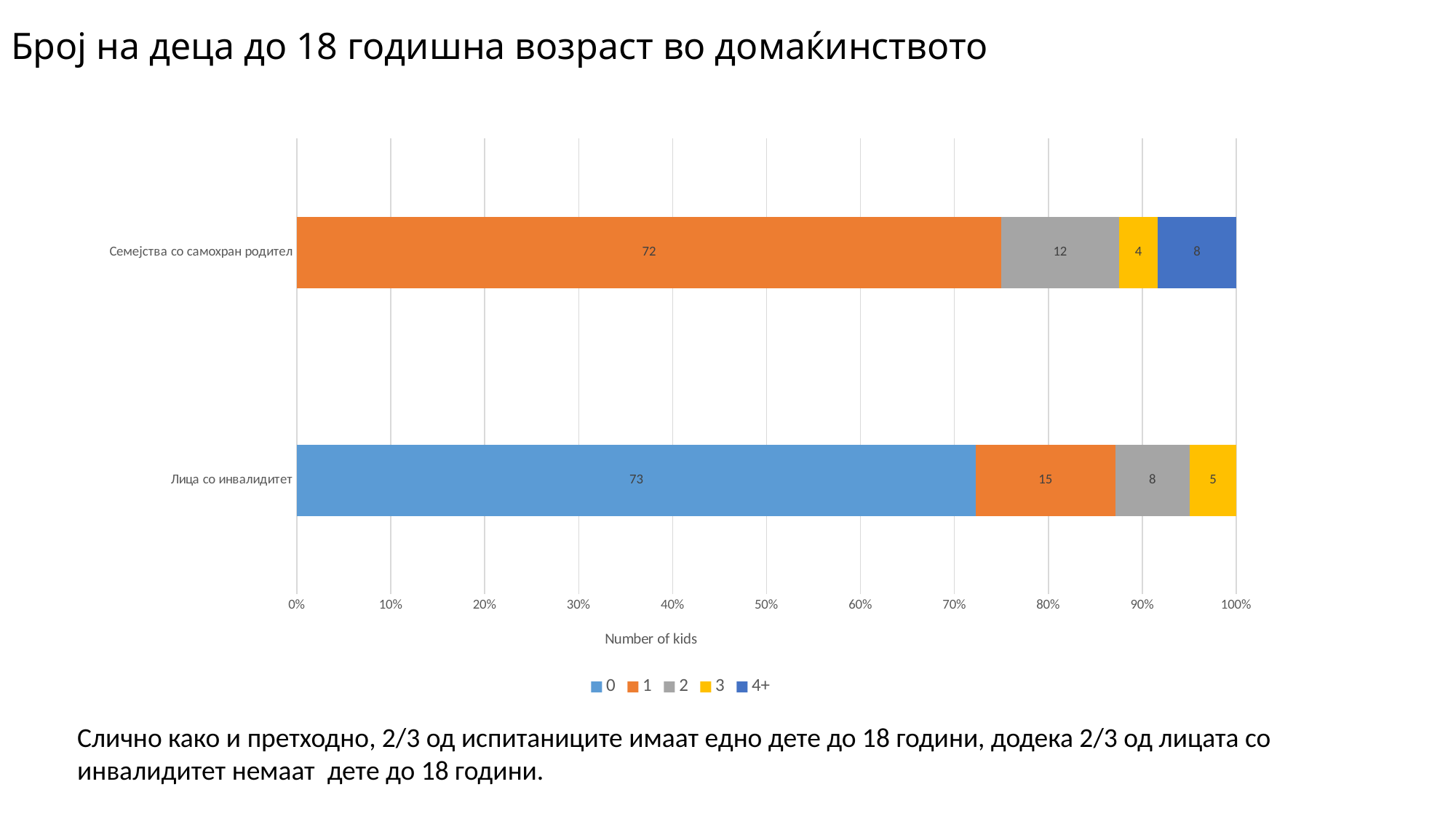
Which is larger: the value for series "2" in "Семејства со самохран родител" or the value for series "2" in "Лица со инвалидитет"? Семејства со самохран родител What kind of chart is shown on the slide? Stacked bar chart What is the value for series "4+" in the "Семејства со самохран родител" bar? 8 What is the value for series "1" in the "Семејства со самохран родител" bar? 72 What is the value for series "3" in the "Лица со инвалидитет" bar? 5 Which series has the largest segment in the "Семејства со самохран родител" bar? 1 What is the difference between the value for series "1" in "Семејства со самохран родител" and the value for series "1" in "Лица со инвалидитет"? 57 What is the total of the segments in the "Лица со инвалидитет" bar? 101 How many series does the legend list? 5 Which series has the smallest segment in the "Лица со инвалидитет" bar? 3 How many categories are shown on the chart? 2 What is the value for series "0" in the "Лица со инвалидитет" bar? 73